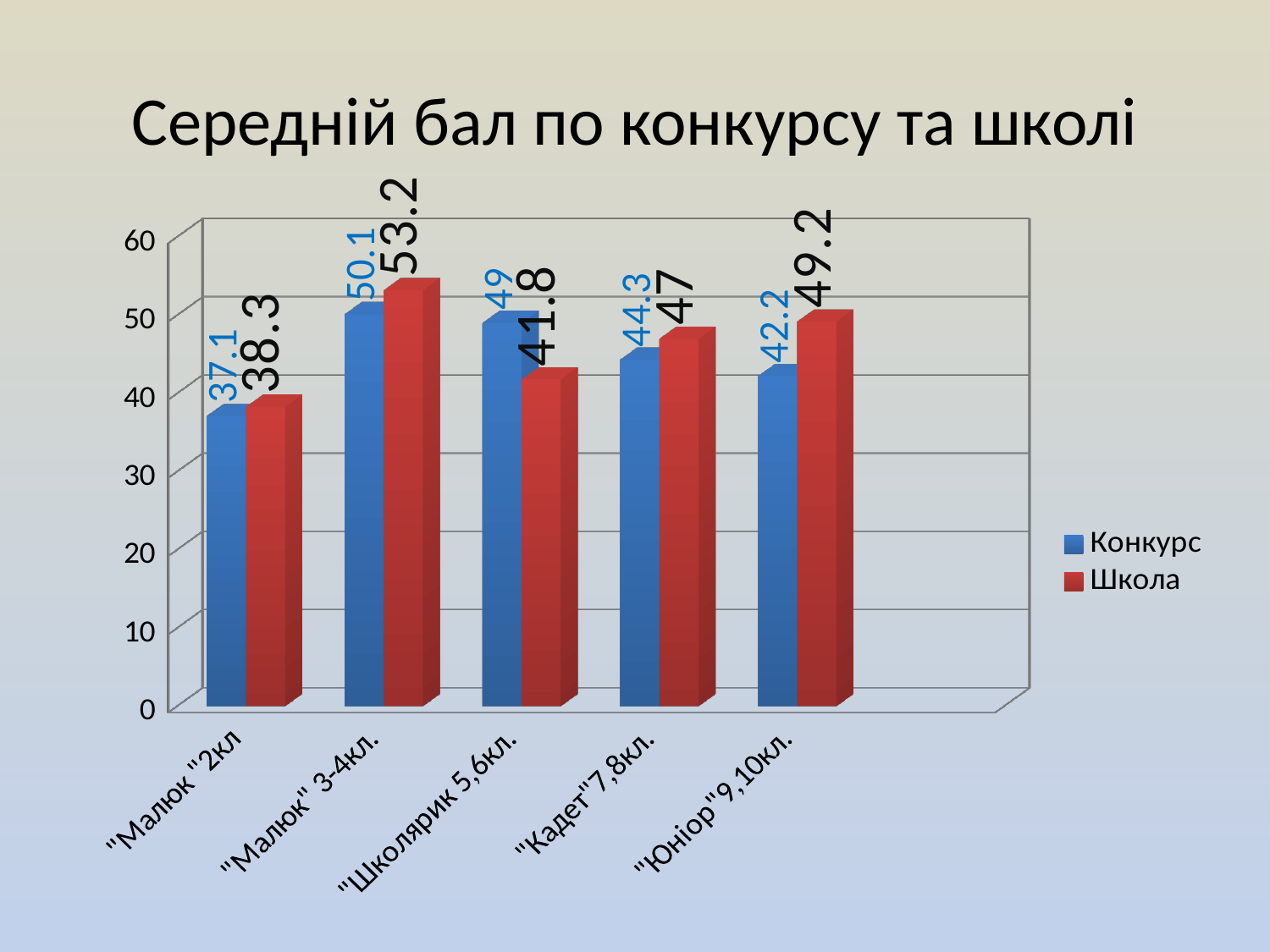
For "Школярик" 5,6кл., which is larger: the Конкурс value or the Школа value? Конкурс What is the Конкурс value for "Кадет" 7,8кл.? 44.3 What is the title of the chart? Середній бал по конкурсу та школі How many series does the legend list? 2 Which category has the lowest Конкурс value? "Малюк" 2кл What is the difference between the Школа and Конкурс values for "Юніор" 9,10кл.? 7 What is the Школа value for "Школярик" 5,6кл.? 41.8 What is the Школа value for "Малюк" 3-4кл.? 53.2 Which category has the highest Школа value? "Малюк" 3-4кл. What kind of chart is shown on the slide? Bar chart How many categories are shown on the x axis? 5 What is the Конкурс value for "Малюк" 2кл? 37.1